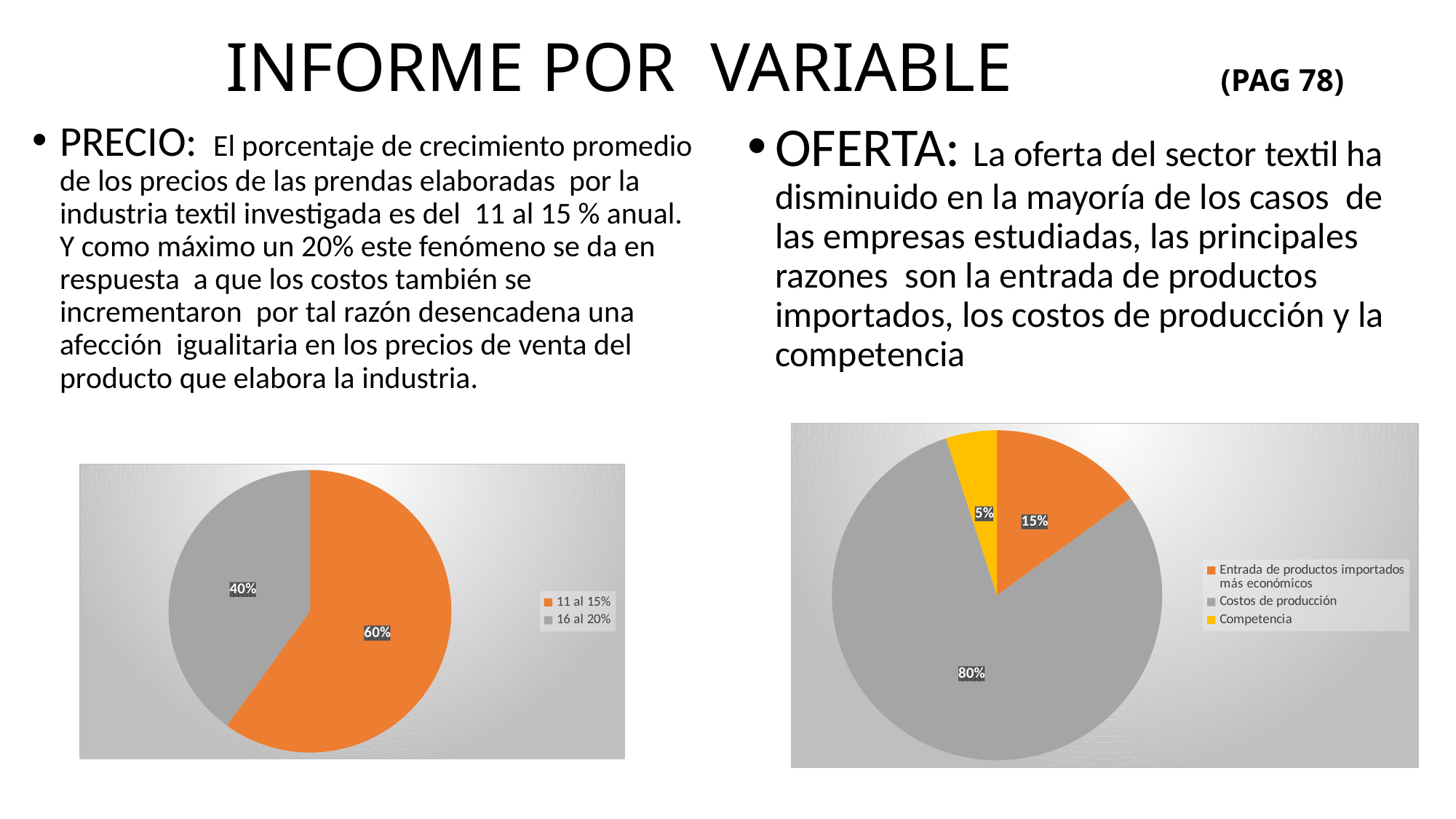
In the left pie chart (under PRECIO), what share is labelled for '16 al 20%'? 40% In the left pie chart (under PRECIO), which category has the largest slice? 11 al 15% In the right pie chart (under OFERTA), what colour is the 'Competencia' slice? Yellow In the right pie chart (under OFERTA), what share is labelled for 'Costos de producción'? 80% In the right pie chart (under OFERTA), how many categories does the legend list? 3 In the right pie chart (under OFERTA), what share is labelled for 'Entrada de productos importados más económicos'? 15% In the left pie chart (under PRECIO), how many slices does the pie have? 2 In the left pie chart (under PRECIO), what is the difference between the '11 al 15%' and '16 al 20%' slices? 20% In the right pie chart (under OFERTA), which category has the smallest slice? Competencia In the right pie chart (under OFERTA), what share is labelled for 'Competencia'? 5% In the left pie chart (under PRECIO), what share is labelled for '11 al 15%'? 60% What kind of chart is shown on the left side of the slide (under PRECIO)? Pie chart